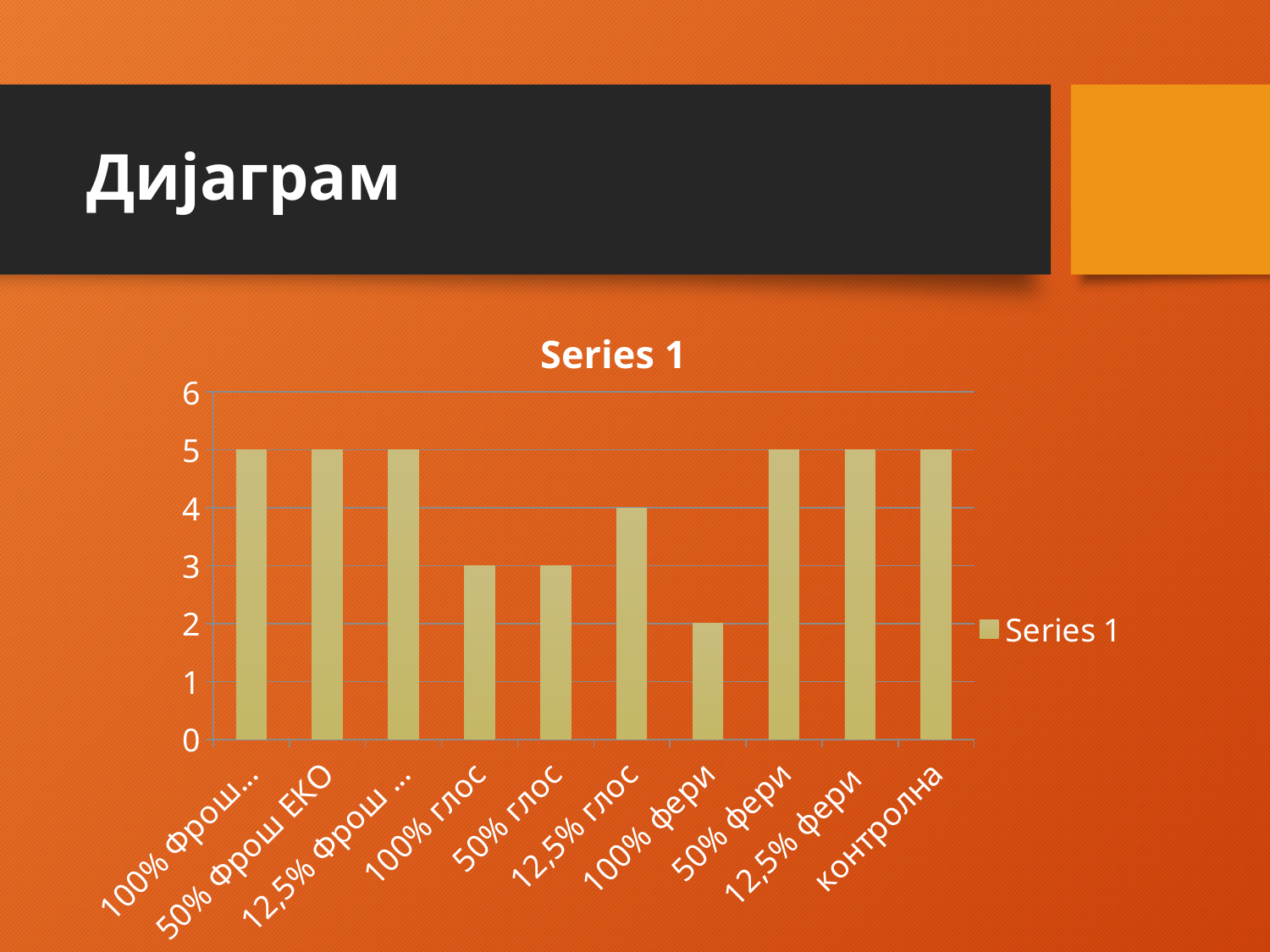
How many series does the legend list? 1 How many categories are shown on the x axis? 10 What is the value for 100% глос? 3 Which is larger, the value for 12,5% глос or the value for 50% глос? 12,5% глос What is the difference between the values for 50% фери and 100% фери? 3 What kind of chart is shown on the slide? bar chart What is the value for контролна? 5 What is the value for 100% фери? 2 What is the value for 12,5% глос? 4 Is the value for 50% глос greater or less than 4? less What is the value for 50% Фрош ЕКО? 5 Which category has the lowest value? 100% фери